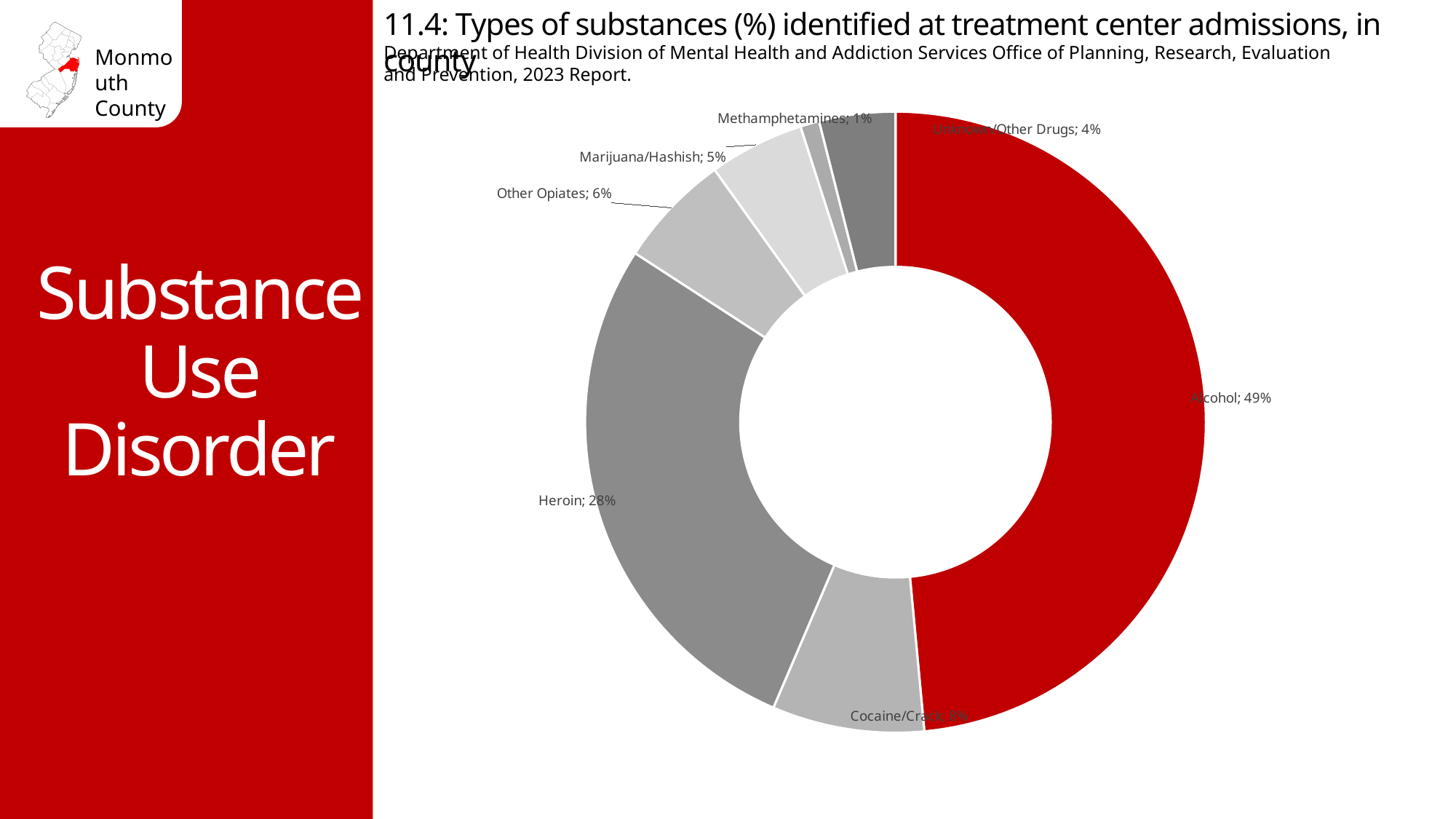
What percentage is shown for Methamphetamines? 1% Which substance has the largest share of treatment center admissions? Alcohol What percentage is shown for Alcohol? 49% What kind of chart is shown on the slide? Pie chart (doughnut) What percentage is shown for Marijuana/Hashish? 5% What percentage is shown for Heroin? 28% What is the difference in percentage points between Alcohol and Heroin? 21 Which substance has the smallest share of treatment center admissions? Methamphetamines Which is larger, the share for Cocaine/Crack or the share for Other Opiates? Cocaine/Crack What percentage is shown for Cocaine/Crack? 8% What percentage is shown for Other Opiates? 6% How many substance categories are shown in the chart? 7